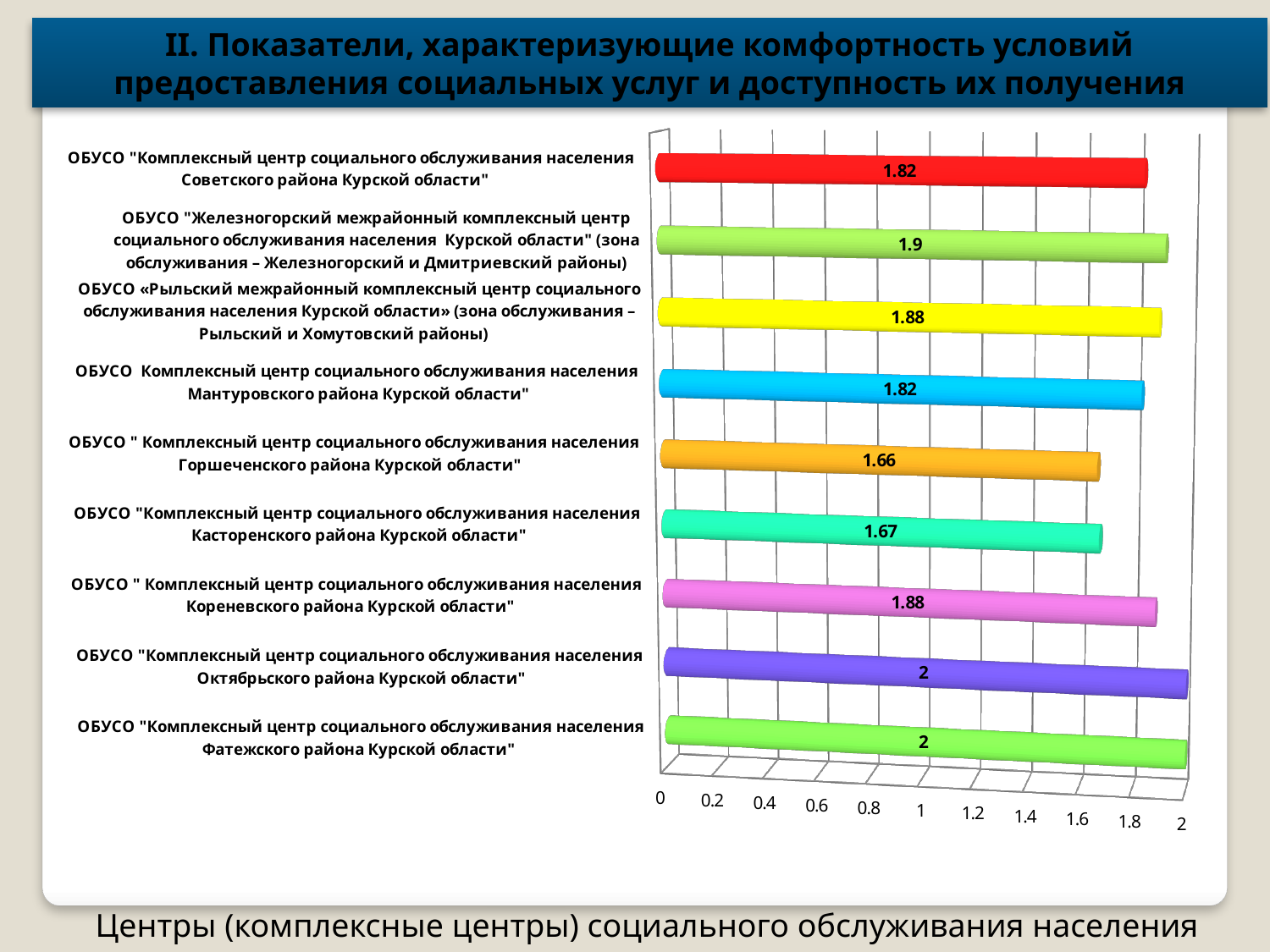
What is the maximum value shown on the horizontal axis? 2 What is the value for ОБУСО "Комплексный центр социального обслуживания населения Советского района Курской области"? 1.82 What is the difference between the value for Железногорский межрайонный центр and the value for Горшеченского района? 0.24 What is the value for ОБУСО "Железногорский межрайонный комплексный центр социального обслуживания населения Курской области"? 1.9 Which category has the lowest value on the chart? ОБУСО "Комплексный центр социального обслуживания населения Горшеченского района Курской области" Is the value for Касторенского района greater or less than 1.8? less What kind of chart is shown on the slide? bar chart How many categories (centres) are plotted on the chart? 9 What is the value for ОБУСО "Комплексный центр социального обслуживания населения Фатежского района Курской области"? 2 Which categories share the highest value on the chart? Октябрьского района and Фатежского района What is the value for ОБУСО "Комплексный центр социального обслуживания населения Горшеченского района Курской области"? 1.66 Which is larger: the value for Рыльский межрайонный центр or the value for Мантуровского района? Рыльский межрайонный центр